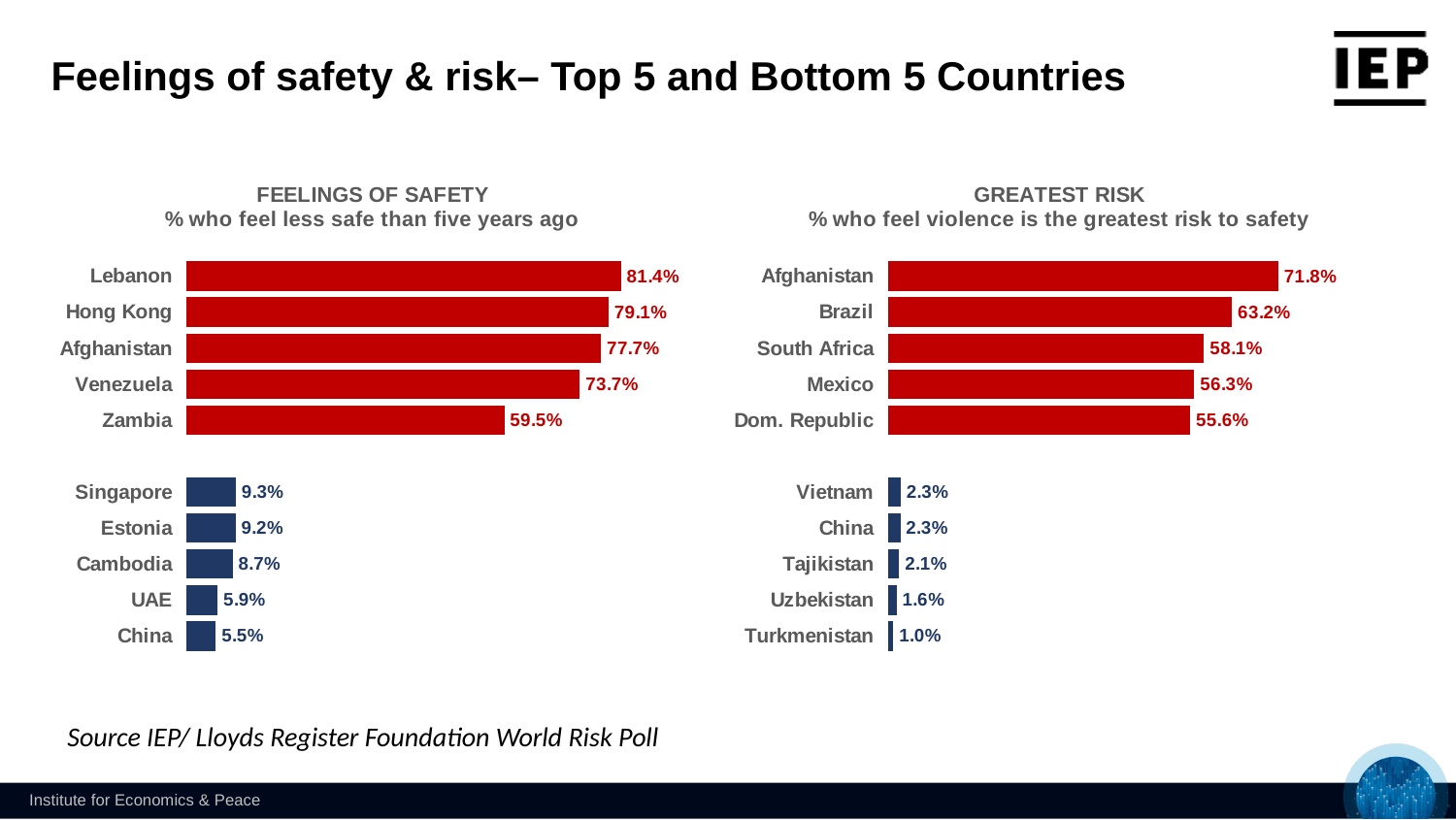
How many countries are shown in the 'Feelings of Safety' chart? 10 In the 'Feelings of Safety' chart, what is the difference between Lebanon and Zambia? 21.9% How many countries are shown in the 'Greatest Risk' chart? 10 In the 'Greatest Risk' chart, what is the difference between Afghanistan and Brazil? 8.6% In the 'Greatest Risk' chart, what is the value for Mexico? 56.3% What type of chart is the 'Greatest Risk' chart? Bar chart In the 'Feelings of Safety' chart, which country has the lowest value? China What is the subtitle of the 'Greatest Risk' chart? % who feel violence is the greatest risk to safety In the 'Greatest Risk' chart, which country has the highest value? Afghanistan In the 'Feelings of Safety' chart, what is the value for Lebanon? 81.4% In the 'Feelings of Safety' chart, which is larger, the value for Venezuela or the value for Zambia? Venezuela In the 'Greatest Risk' chart, which is larger, the value for South Africa or the value for Dom. Republic? South Africa